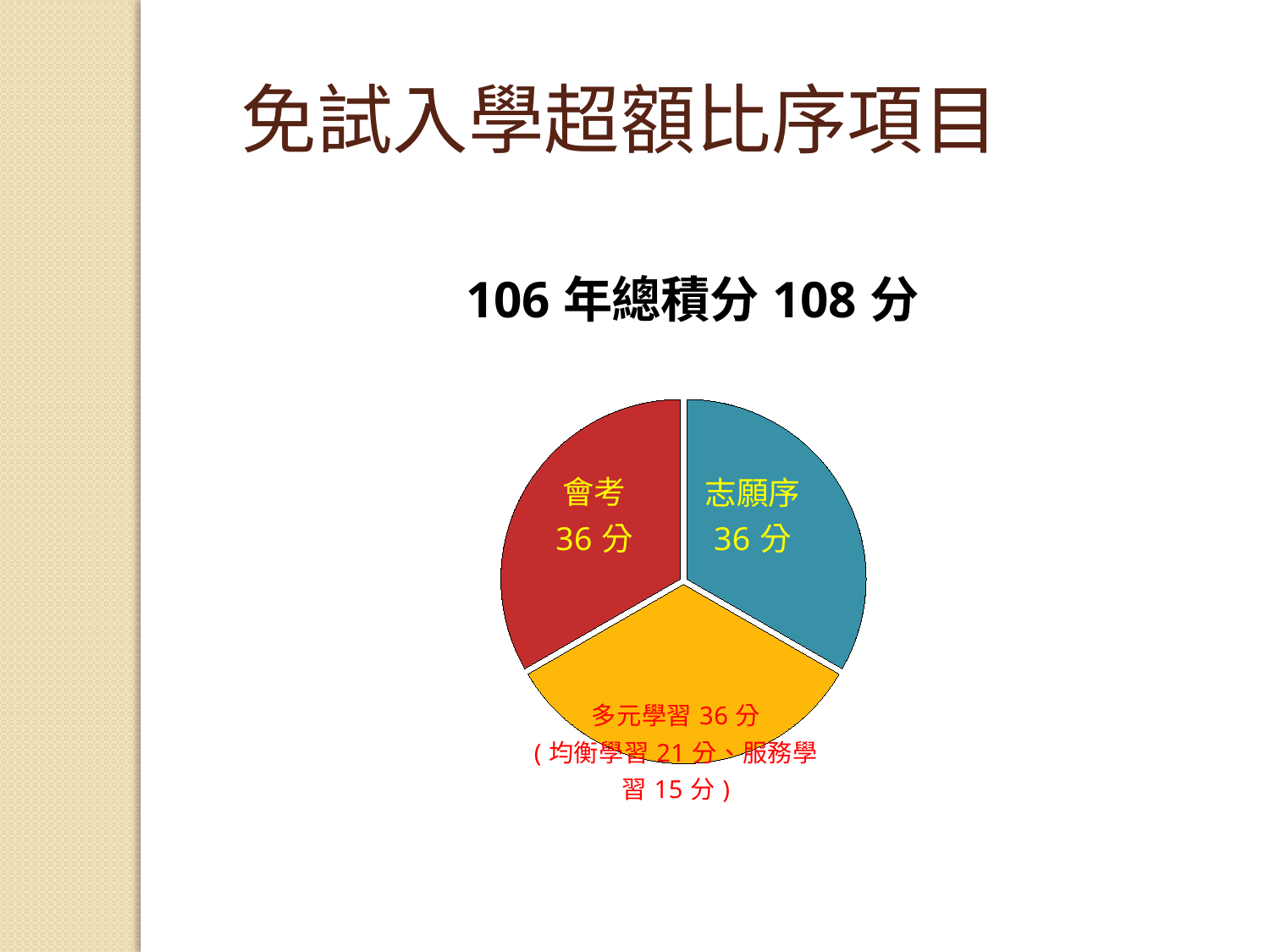
What is the difference between the 均衡學習 points and the 服務學習 points? 6 分 What colour is the 會考 slice of the pie chart? red What is the heading printed directly above the pie chart? 106 年總積分 108 分 According to the label on the 多元學習 slice, how many points is 服務學習 worth? 15 分 What is the value shown for 志願序 in the pie chart? 36 分 What share of the 108-point total does the 志願序 slice represent? one third What is the value shown for 多元學習 in the pie chart? 36 分 What is the total score stated above the pie chart? 108 分 According to the label on the 多元學習 slice, how many points is 均衡學習 worth? 21 分 How many slices does the pie chart have? 3 What kind of chart is shown on the slide? pie chart What is the value shown for 會考 in the pie chart? 36 分